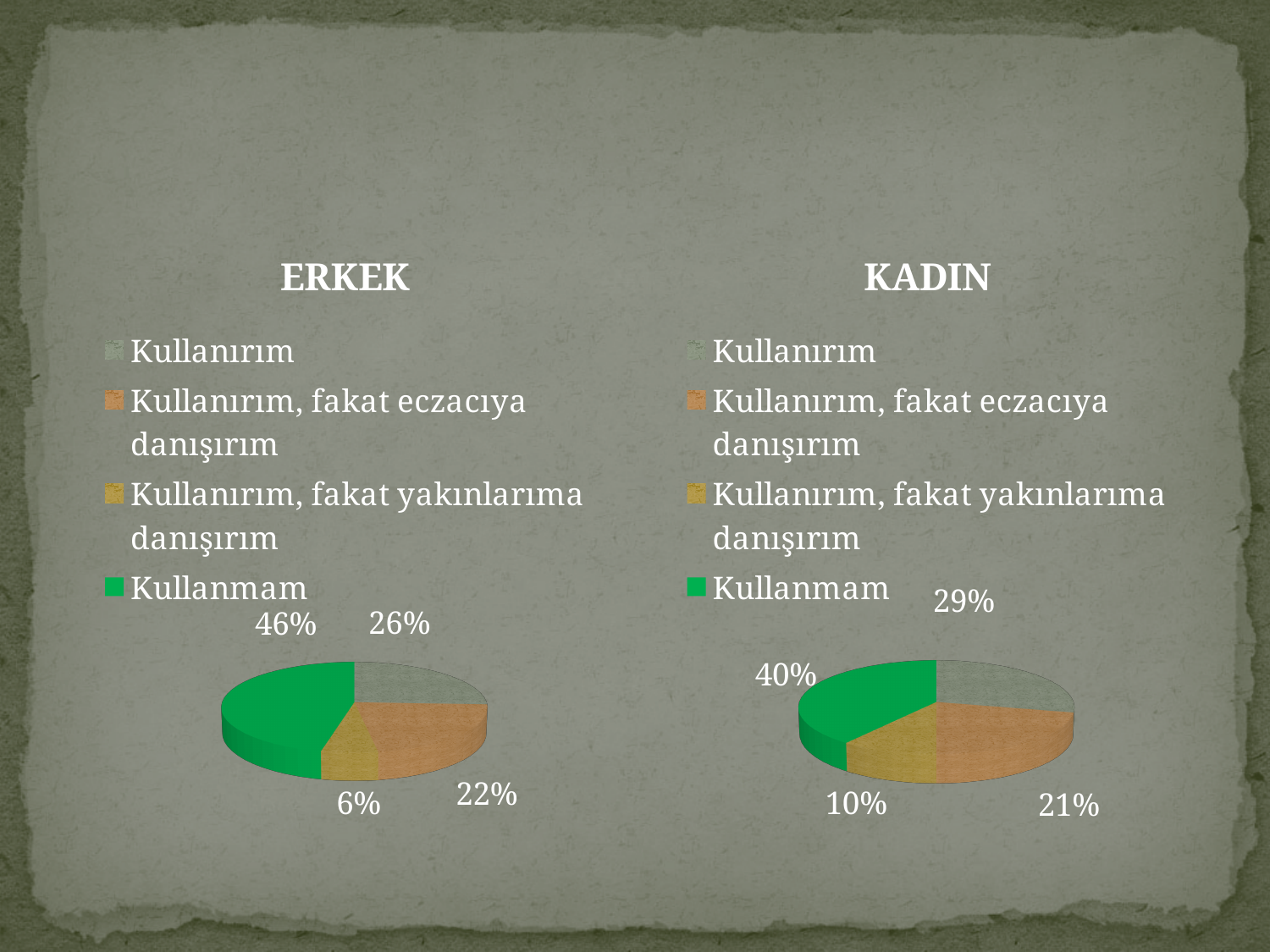
In the ERKEK pie chart, what is the difference between the Kullanırım share and the Kullanırım, fakat eczacıya danışırım share? 4% How many slices does the KADIN pie chart have? 4 In the KADIN chart legend, which colour represents Kullanmam? Green Which is larger: the Kullanırım share in the ERKEK chart or the Kullanırım share in the KADIN chart? KADIN What type of chart is used for the ERKEK data? Pie chart In the ERKEK pie chart, what percentage is shown for Kullanırım? 26% In the ERKEK pie chart, what percentage is shown for Kullanmam? 46% In the KADIN pie chart, what percentage is shown for Kullanmam? 40% In the ERKEK pie chart, which category has the largest share? Kullanmam What is the difference between the Kullanmam share in the ERKEK chart and the Kullanmam share in the KADIN chart? 6% In the KADIN pie chart, which category has the smallest share? Kullanırım, fakat yakınlarıma danışırım In the KADIN pie chart, what percentage is shown for Kullanırım, fakat yakınlarıma danışırım? 10%